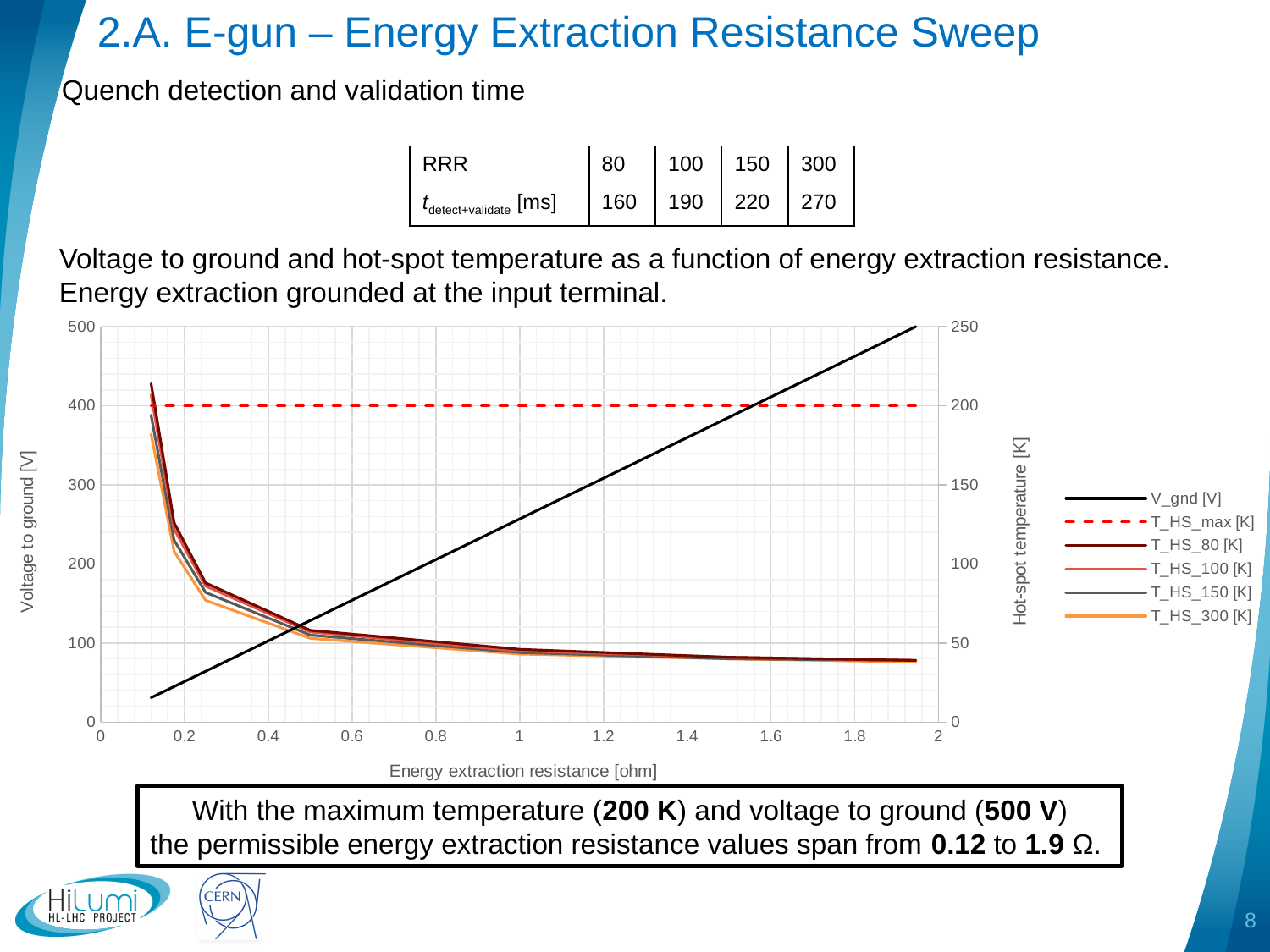
What is the label of the x axis of the chart? Energy extraction resistance [ohm] What is the label of the right-hand y axis of the chart? Hot-spot temperature [K] At 0.2 ohm, which series is higher: T_HS_80 [K] or T_HS_300 [K]? T_HS_80 [K] How many series does the chart legend list? 6 Does the V_gnd [V] line rise or fall as energy extraction resistance increases? rise Is the value of T_HS_80 [K] at 1 ohm greater or less than 50 on the right axis? less Is the value of V_gnd [V] at 1 ohm greater or less than 300? less What constant value does the dashed T_HS_max [K] line sit at on the right axis? 200 What kind of chart is shown on the slide? line chart Does the T_HS_80 [K] line rise or fall as energy extraction resistance increases? fall Is the value of V_gnd [V] at 1.8 ohm greater or less than 400? greater